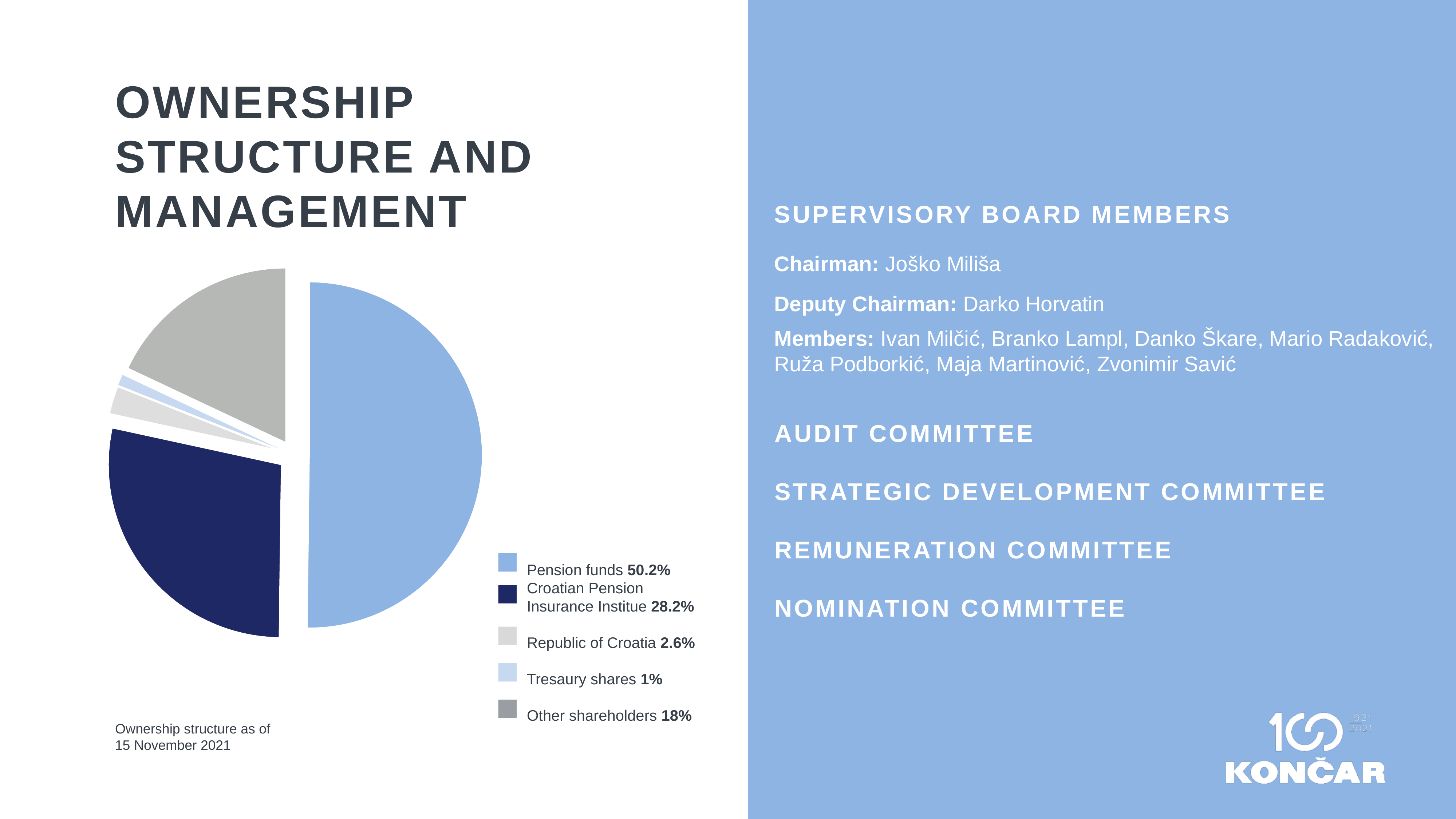
Which shareholder category has the smallest share of ownership? Tresaury shares What share of ownership do Other shareholders hold? 18% What share of ownership does the Croatian Pension Insurance Institue hold? 28.2% What share of ownership does the Republic of Croatia hold? 2.6% Which shareholder category has the largest share of ownership? Pension funds What is the difference between the Pension funds share and the Croatian Pension Insurance Institue share? 22% Which is larger: the share of Other shareholders or the share of the Republic of Croatia? Other shareholders What kind of chart is used to show the ownership structure? Pie chart What share of ownership do Pension funds hold? 50.2% As of what date is the ownership structure shown? 15 November 2021 How many shareholder categories does the pie chart show? 5 What share of ownership do Tresaury shares represent? 1%